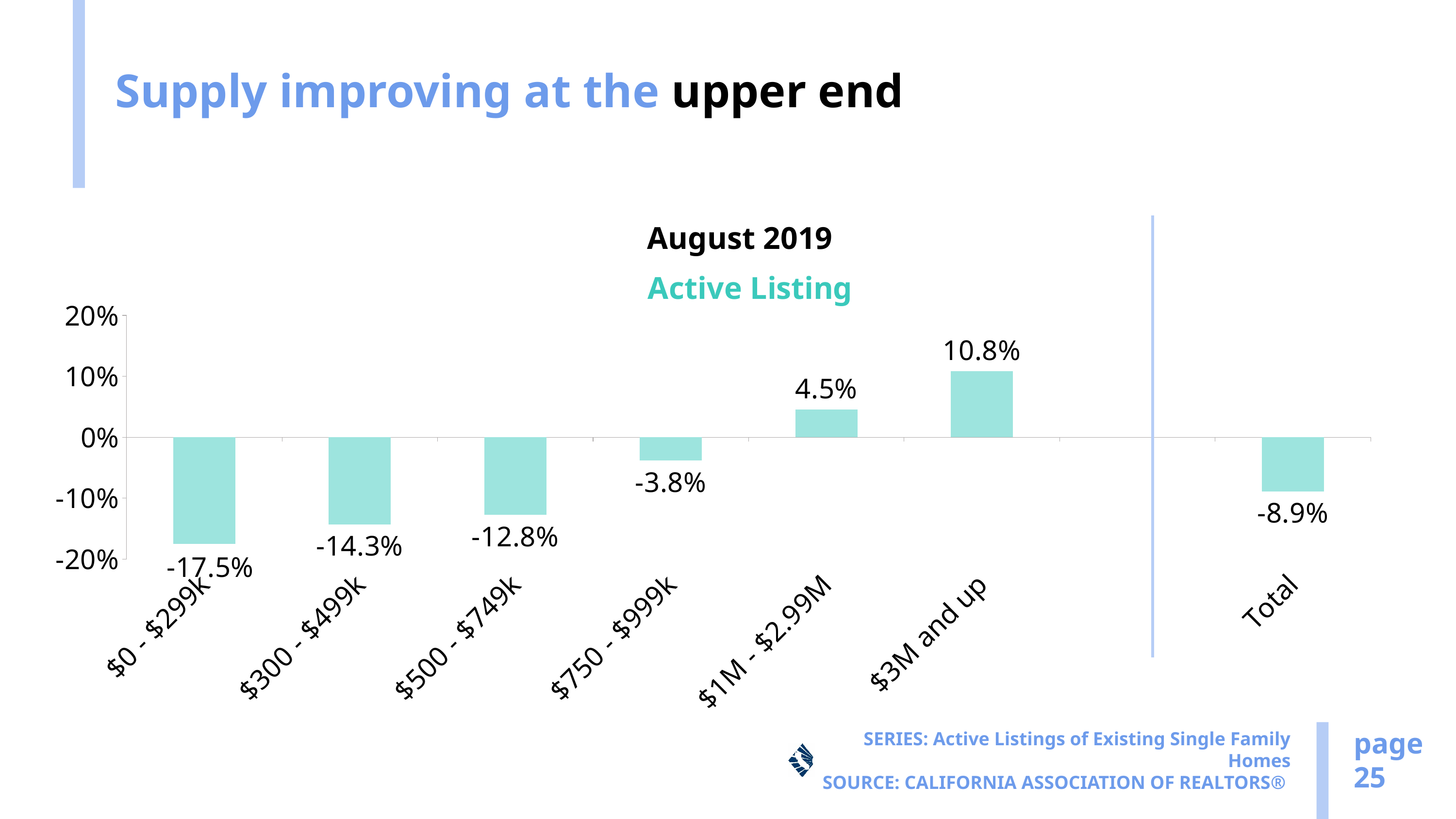
What is the value for the $750 - $999k price range? -3.8% Which price range has the lowest value? $0 - $299k Which price range has the highest value? $3M and up What month and year does the chart cover? August 2019 Which is larger, the value for $300 - $499k or the value for $500 - $749k? $500 - $749k Do the values generally rise or fall moving from the lowest price range to the highest? Rise How many price-range categories are shown, excluding Total? 6 What is the value for the $3M and up price range? 10.8% What is the difference between the values for $3M and up and $1M - $2.99M? 6.3 percentage points What is the value for the $0 - $299k price range? -17.5% What is the value for the Total category? -8.9% What kind of chart is shown on the slide? Bar chart